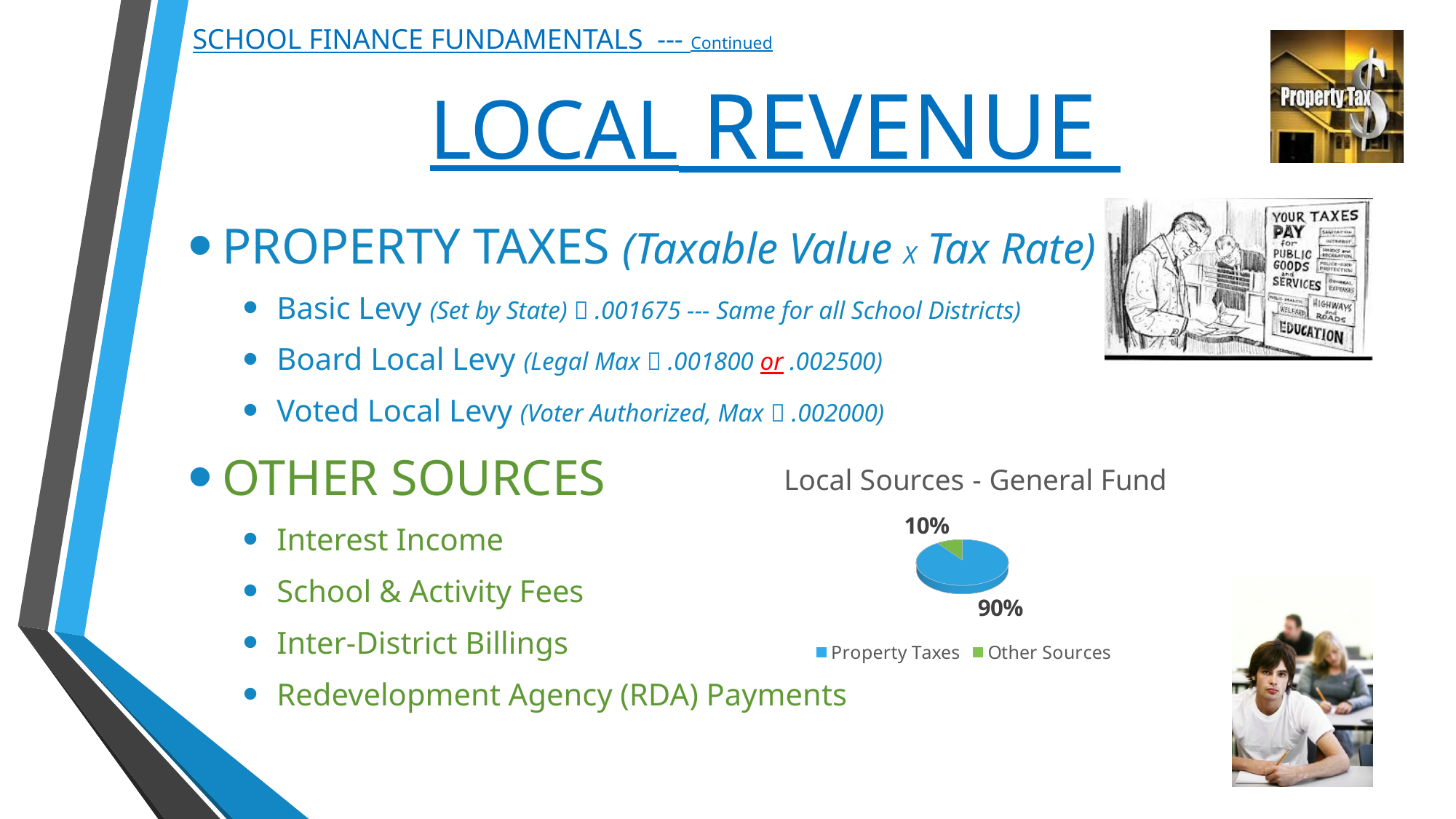
What colour is the Property Taxes slice in the pie chart? blue What share of the pie does Property Taxes represent? 90% Which slice of the pie is the smallest? Other Sources What is the difference in percentage points between the Property Taxes slice and the Other Sources slice? 80 How many entries does the chart legend list? 2 What is the title of the chart on the slide? Local Sources - General Fund What share of the pie does Other Sources represent? 10% How many slices does the pie chart have? 2 Which slice of the pie is the largest? Property Taxes Which is larger, the Property Taxes slice or the Other Sources slice? Property Taxes What kind of chart is shown on the slide? pie chart